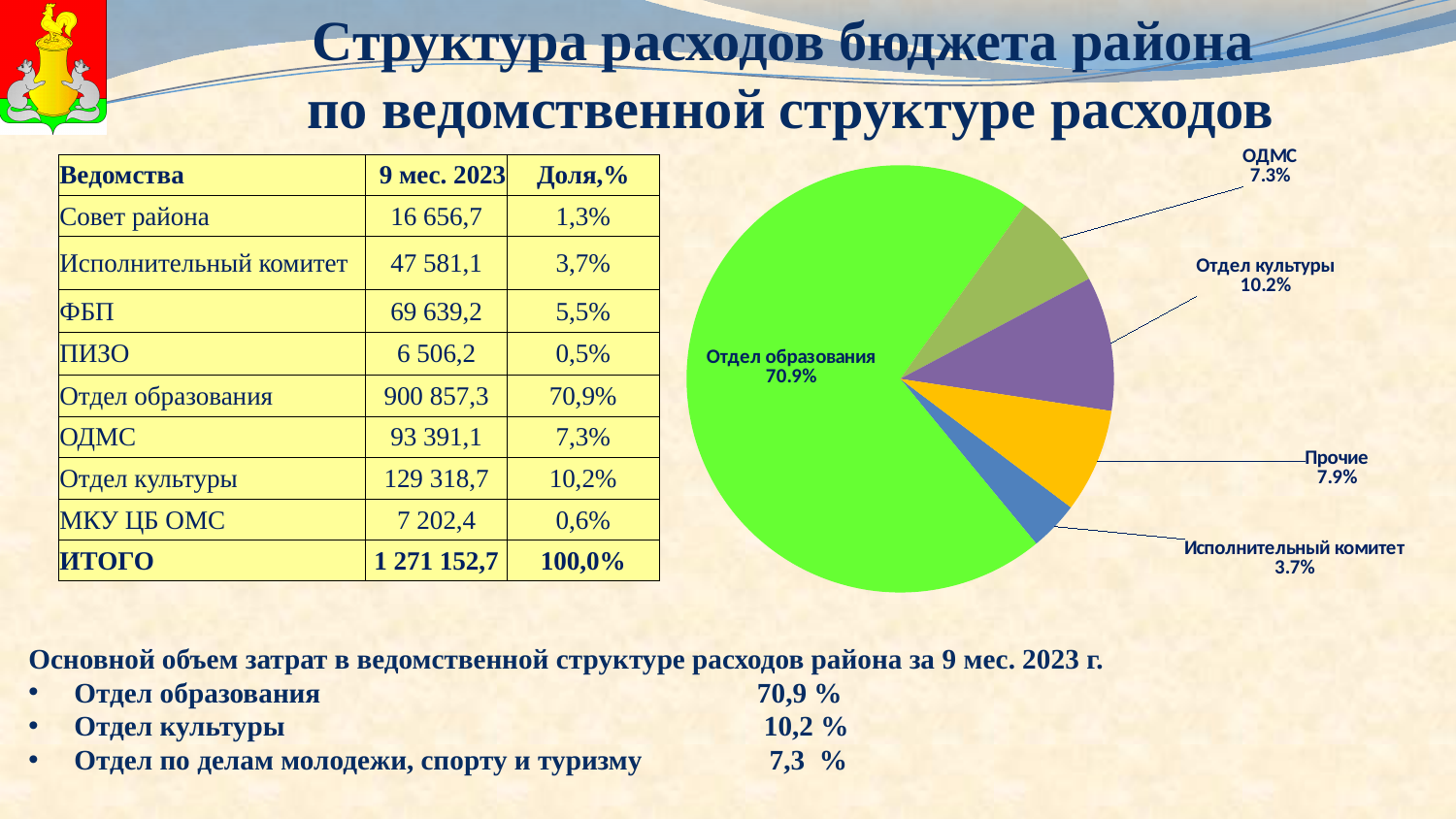
Which is larger in the pie chart, Отдел культуры or ОДМС? Отдел культуры Which slice of the pie chart is the largest? Отдел образования How many slices does the pie chart have? 5 What share of the pie does Исполнительный комитет have? 3.7% What share of the pie does Отдел образования have? 70.9% What colour is the Отдел образования slice in the pie chart? green What share of the pie does Прочие have? 7.9% What kind of chart is shown on the slide? pie chart What share of the pie does ОДМС have? 7.3% What share of the pie does Отдел культуры have? 10.2% What is the difference in percentage points between Отдел культуры and Прочие in the pie chart? 2.3 Which slice of the pie chart is the smallest? Исполнительный комитет